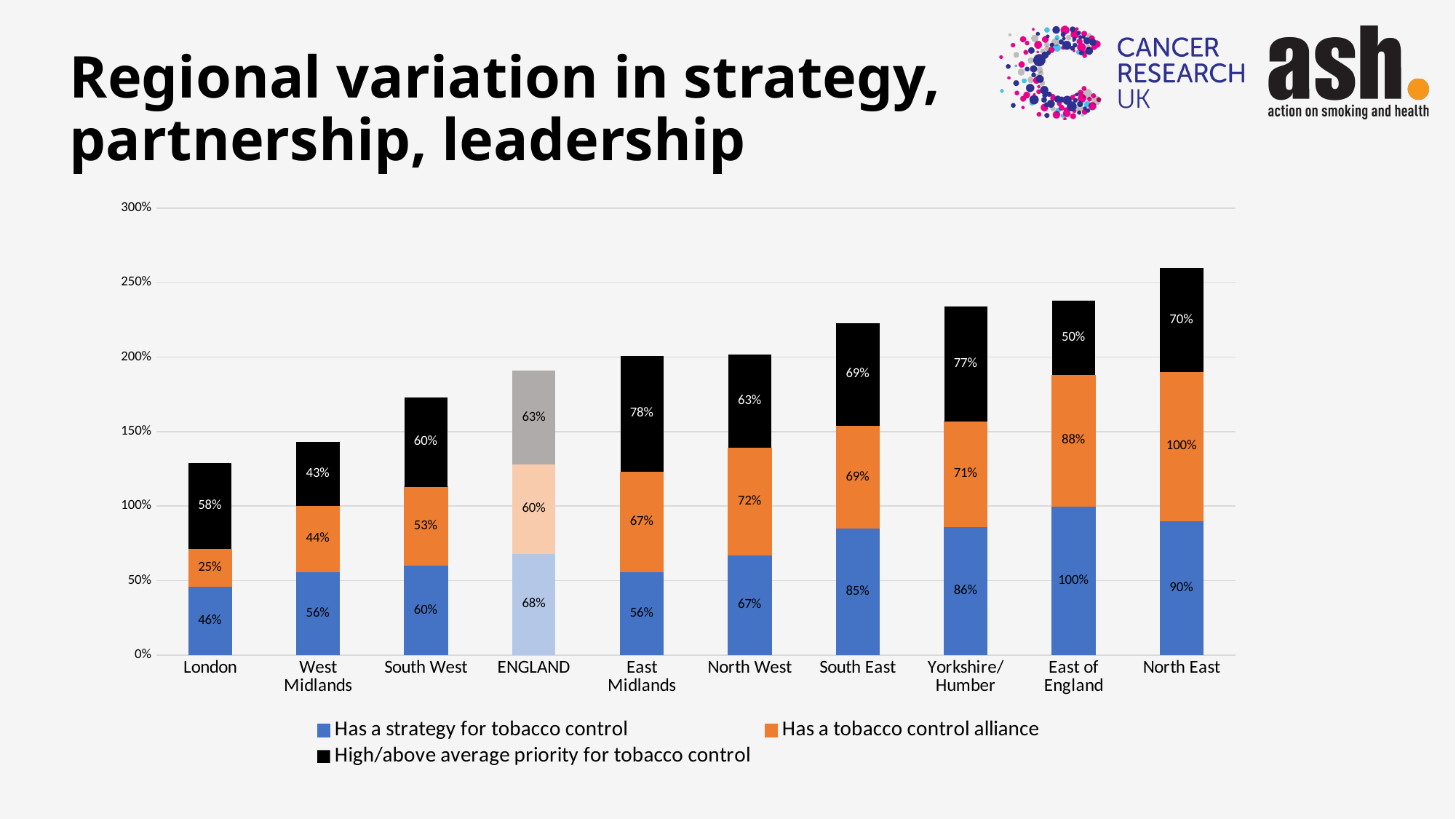
What is the value for 'High/above average priority for tobacco control' in the East Midlands? 78% What is the difference between the 'Has a strategy for tobacco control' values for the North East and London? 44% What is the value for 'Has a strategy for tobacco control' in London? 46% Which region has the highest value for 'Has a strategy for tobacco control'? East of England How many regions (categories) are shown on the x axis? 10 What kind of chart is shown on the slide? Stacked bar chart Which series is shown in black in the legend? High/above average priority for tobacco control How many series does the legend list? 3 Which region has the lowest value for 'Has a tobacco control alliance'? London What is the total of the stacked bar for the North East? 260% Which is larger: the 'High/above average priority for tobacco control' value for Yorkshire/Humber or for East of England? Yorkshire/Humber What is the value for 'Has a tobacco control alliance' in the North East? 100%